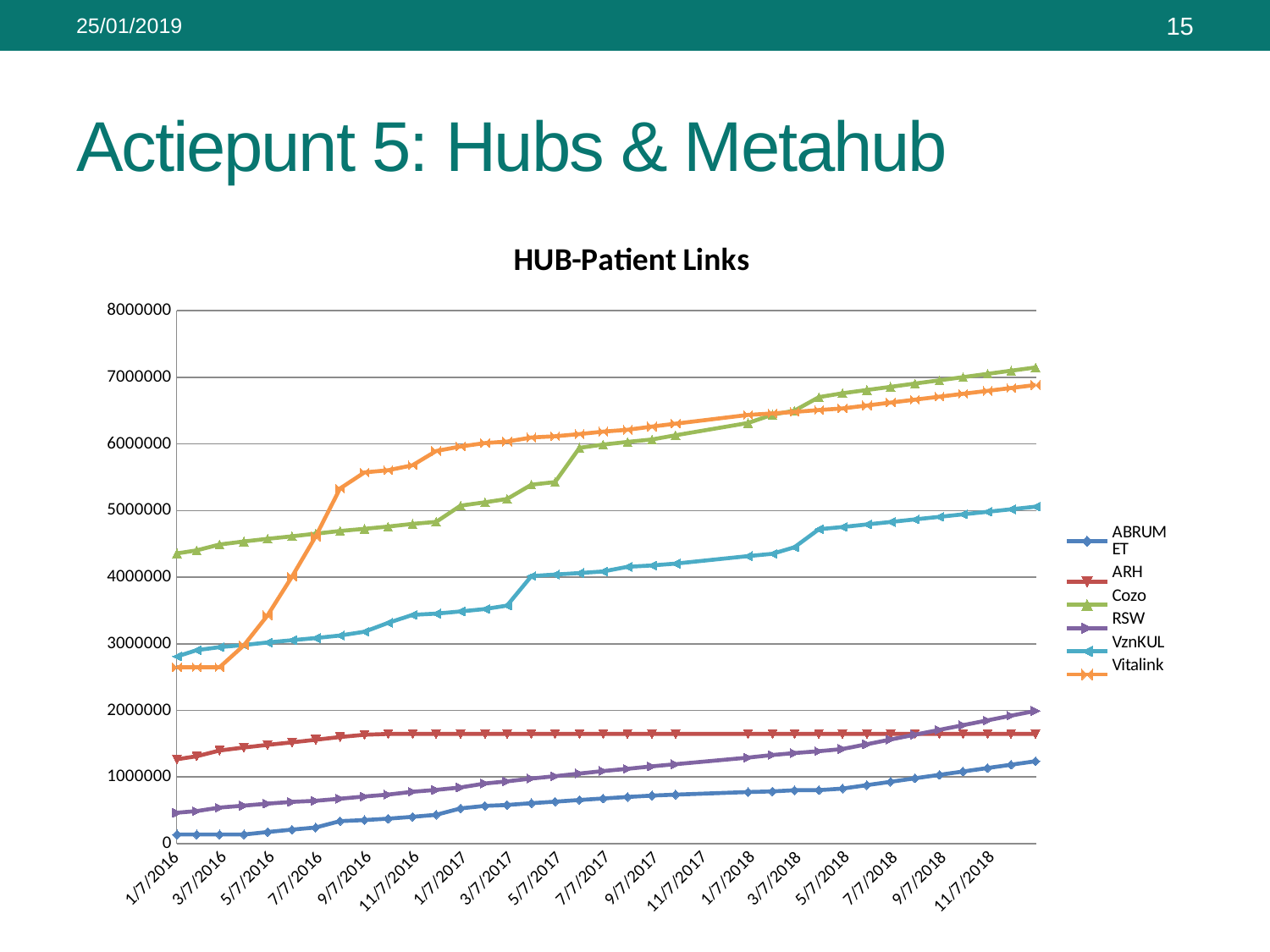
At 1/7/2016, which is larger, the value for Cozo or the value for Vitalink? Cozo Does the Vitalink series rise or fall from 1/7/2016 to 11/7/2018? rise Is the value for ARH at 11/7/2018 greater or less than 2000000? less What kind of chart is shown on the slide? line chart How many series does the legend of the HUB-Patient Links chart list? 6 Which series is drawn in orange on the chart? Vitalink Is the value for VznKUL at 11/7/2018 greater or less than 4000000? greater Which series has the lowest value at the first date, 1/7/2016? ABRUMET Is the value for Cozo at 1/7/2016 greater or less than 4000000? greater What is the title of the chart? HUB-Patient Links Which series has the highest value at the last date on the chart? Cozo